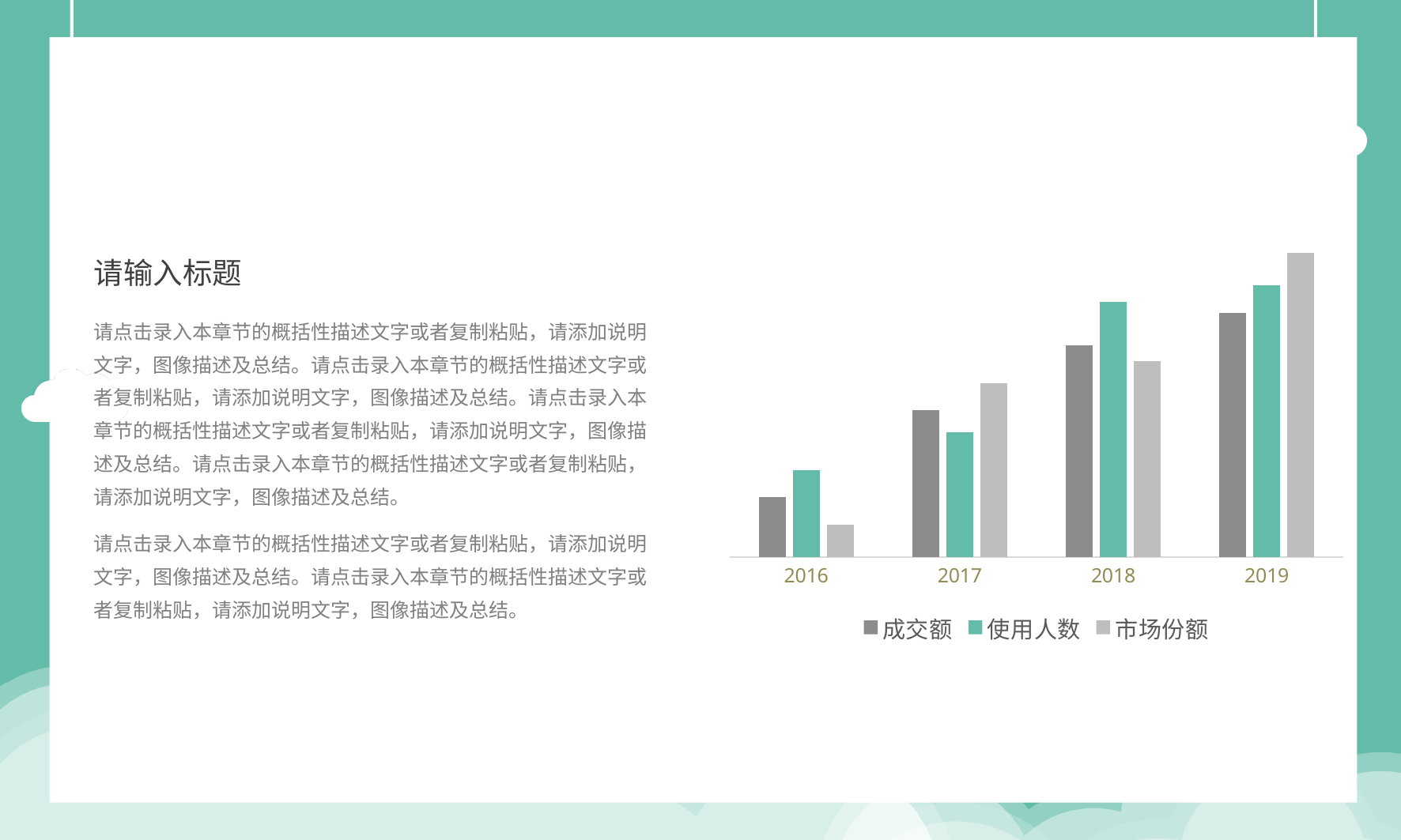
What kind of chart is shown on the slide? bar chart How many years are shown on the x axis of the chart? 4 In 2018, which is larger: 使用人数 or 市场份额? 使用人数 Which series is shown in teal in the chart? 使用人数 Do the values for 成交额 rise or fall from 2016 to 2019? rise What are the three series listed in the chart's legend? 成交额, 使用人数, 市场份额 Which series has the lowest value in 2016? 市场份额 In which year is the value for 成交额 highest? 2019 In which year is the value for 使用人数 lowest? 2016 Do the values for 市场份额 rise or fall from 2016 to 2019? rise Which series has the highest value in 2019? 市场份额 How many series does the chart's legend list? 3